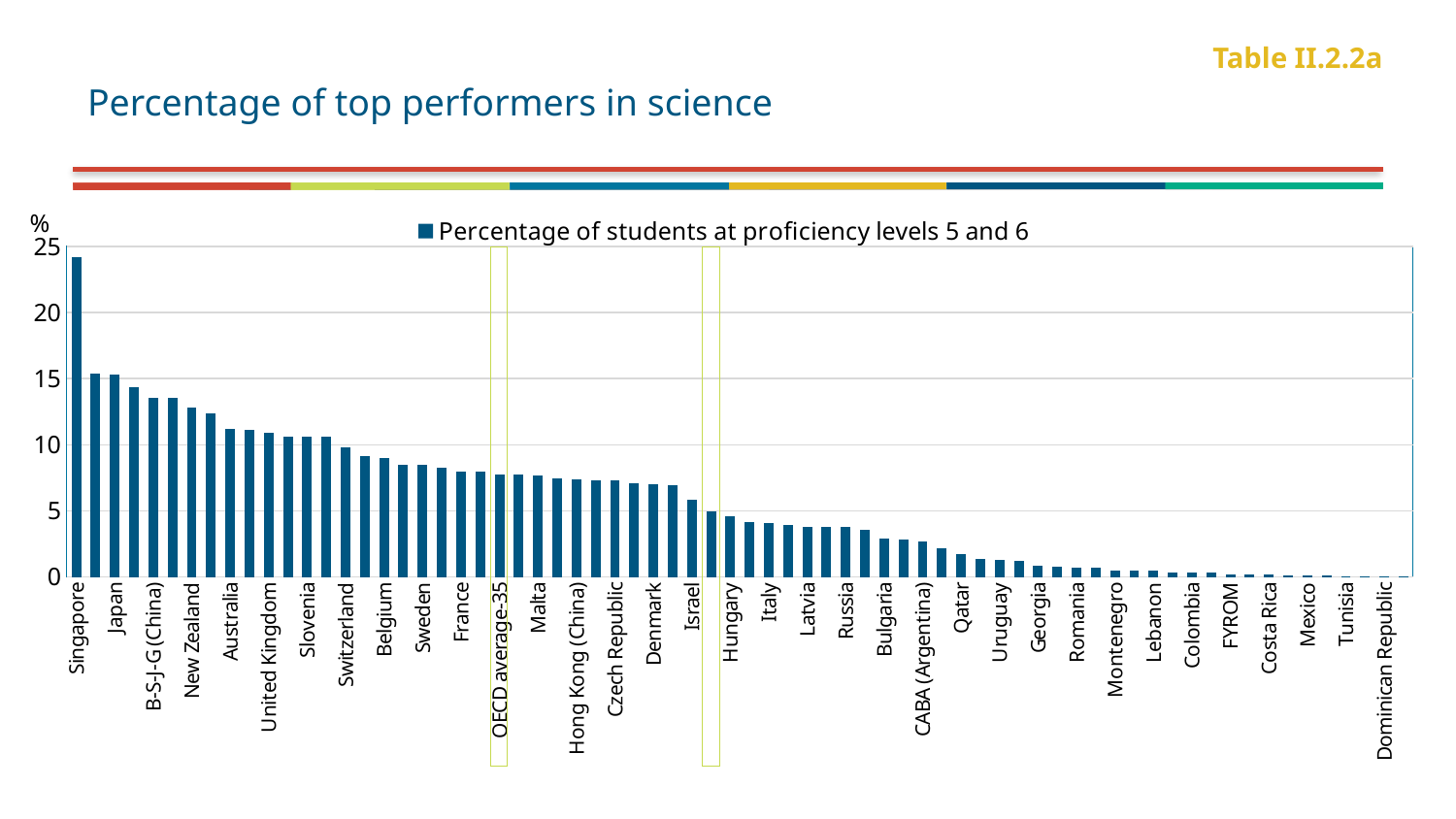
Is the value for Singapore greater or less than 20? greater How many series does the legend list? 1 Is the value for Italy greater or less than 5? less Is the value for OECD average-35 greater or less than 5? greater Which has a higher percentage of top performers in science, Singapore or Japan? Singapore What type of chart is shown on the slide? bar chart Do the values rise or fall moving from left to right along the x axis? fall Which country has the highest percentage of top performers in science? Singapore Which has a higher percentage of top performers in science, Hungary or Australia? Australia